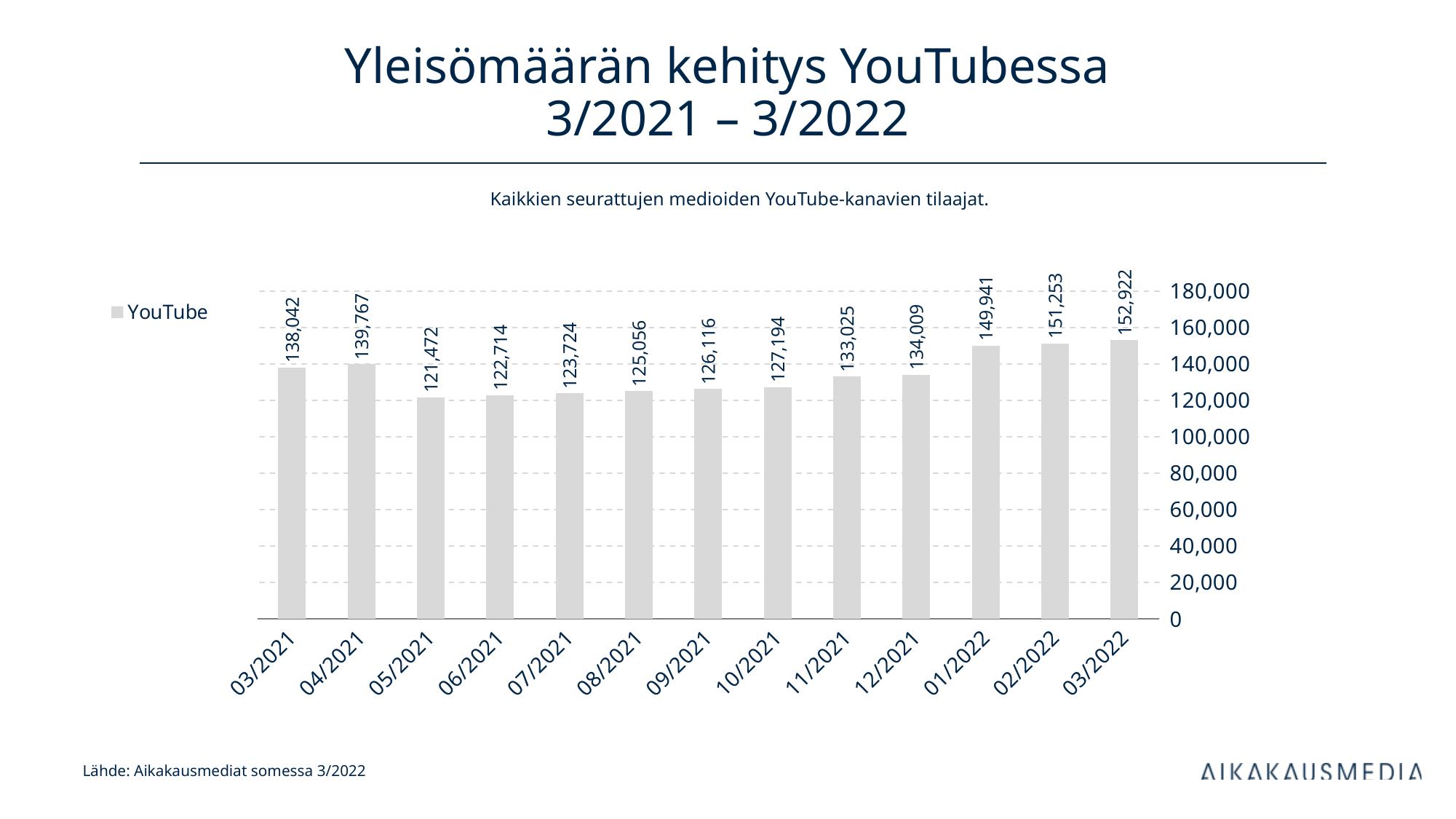
What is the value for 03/2021? 138,042 Which month has the lowest value? 05/2021 How many series does the legend list? 1 What kind of chart is shown on the slide? bar chart How many months are shown on the x axis? 13 What is the value for 09/2021? 126,116 Is the value for 02/2022 greater or less than 140,000? greater Which is larger, the value for 04/2021 or the value for 12/2021? 04/2021 What is the difference between the values for 03/2022 and 03/2021? 14,880 Which month has the highest value? 03/2022 What is the difference between the values for 04/2021 and 05/2021? 18,295 What is the value for 01/2022? 149,941